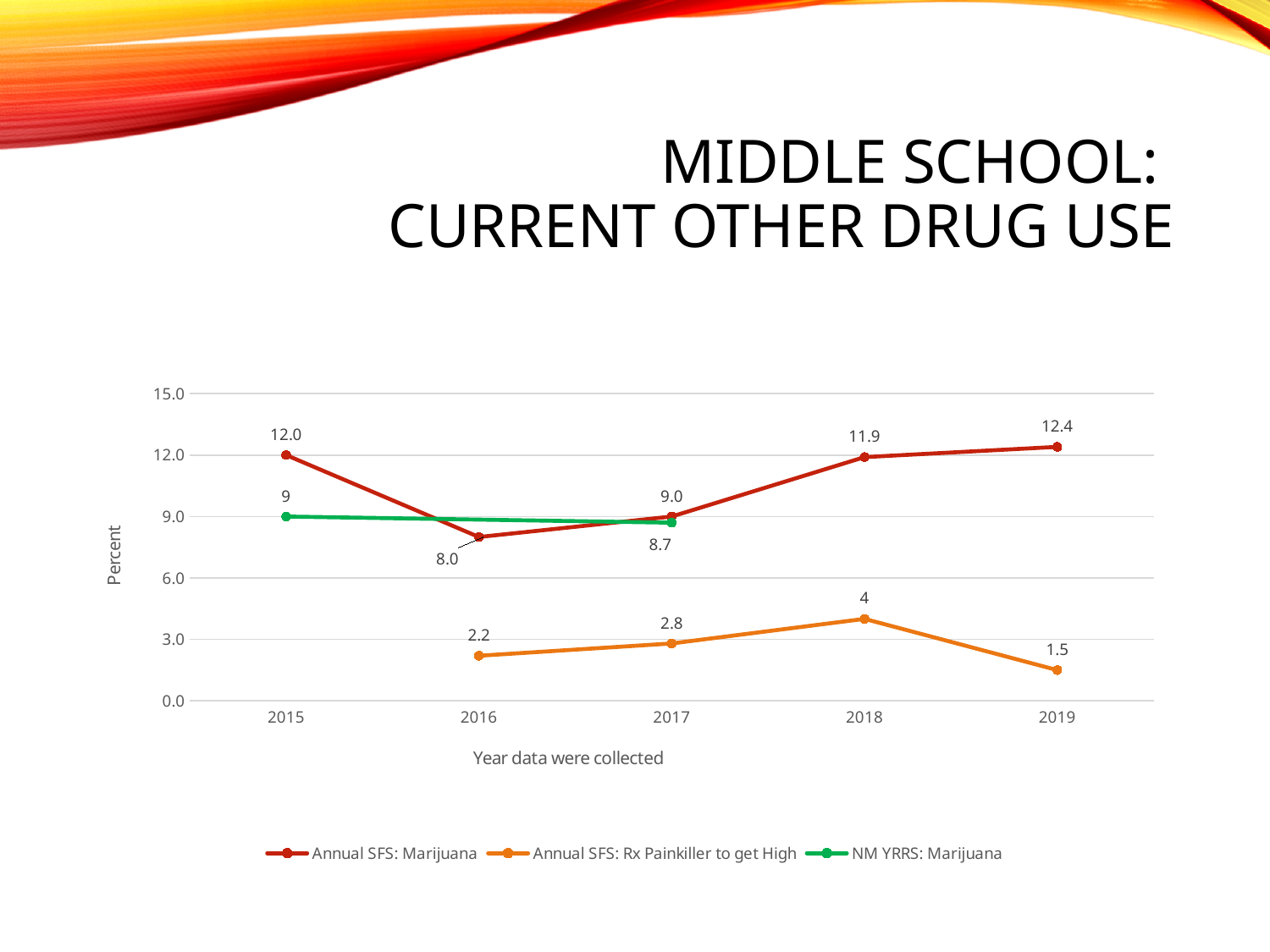
Which is larger in 2015: Annual SFS: Marijuana or NM YRRS: Marijuana? Annual SFS: Marijuana What type of chart is shown on the slide? line chart What is the value for NM YRRS: Marijuana in 2017? 8.7 In which year is Annual SFS: Marijuana highest? 2019 Does Annual SFS: Marijuana rise or fall from 2016 to 2019? rise In which year is Annual SFS: Rx Painkiller to get High lowest? 2019 How many series does the legend list? 3 What is the label of the y axis? Percent What is the difference between the Annual SFS: Marijuana values for 2019 and 2016? 4.4 What is the value for Annual SFS: Marijuana in 2016? 8.0 How many years are shown on the x axis? 5 What is the value for Annual SFS: Rx Painkiller to get High in 2018? 4